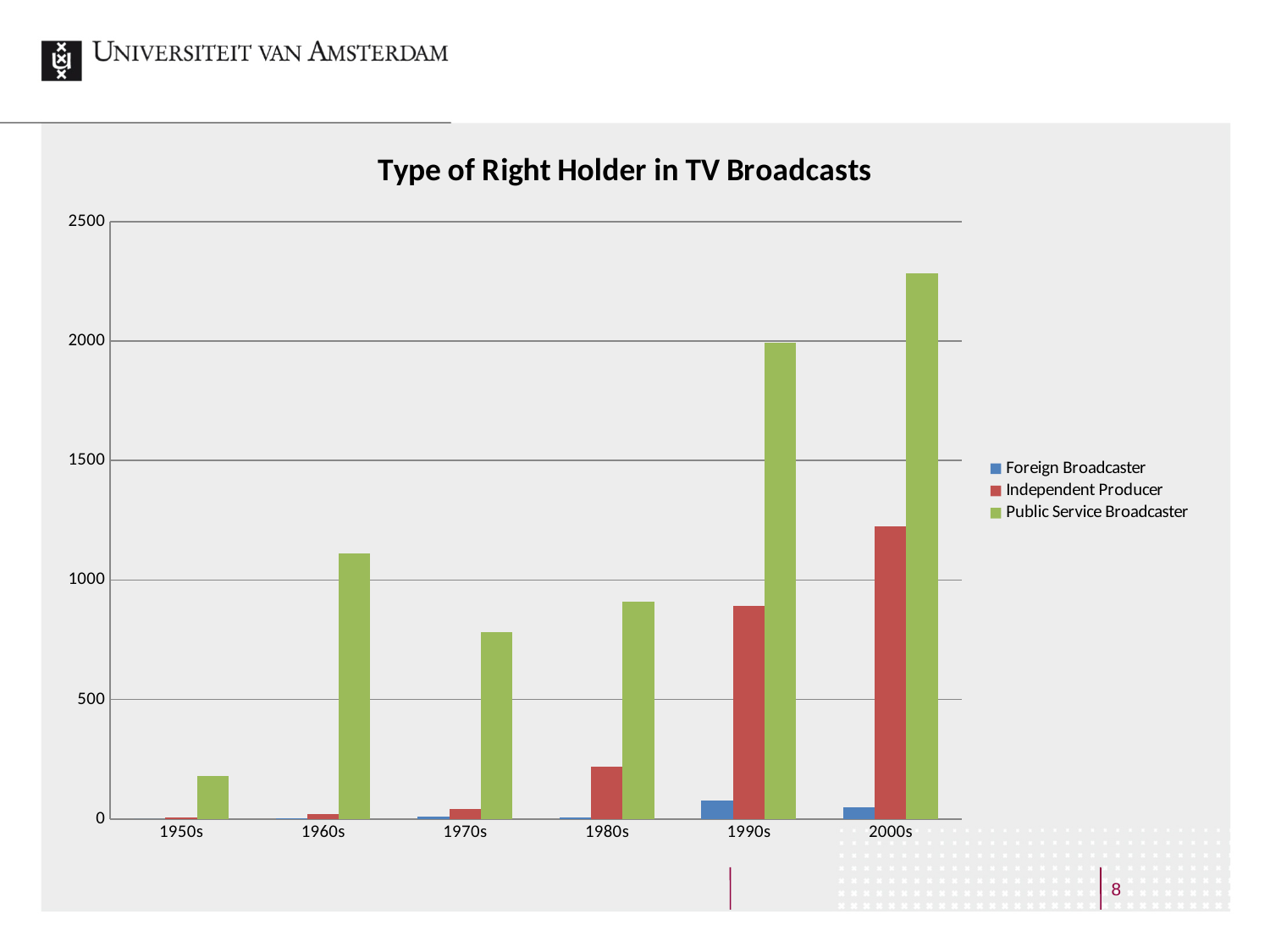
Is the Independent Producer value for the 2000s greater or less than 1000? greater Is the Public Service Broadcaster value for the 1970s greater or less than 1000? less Does the Independent Producer value rise or fall from the 1950s to the 2000s? rise How many decades are shown on the x axis? 6 How many series does the legend list? 3 In the 2000s, which is larger: Independent Producer or Public Service Broadcaster? Public Service Broadcaster What is the title of the chart? Type of Right Holder in TV Broadcasts What kind of chart is shown on the slide? bar chart In which decade is the Public Service Broadcaster value lowest? 1950s In which decade is the Public Service Broadcaster value highest? 2000s Is the Public Service Broadcaster value for the 2000s greater or less than 2000? greater Which series is shown in green? Public Service Broadcaster